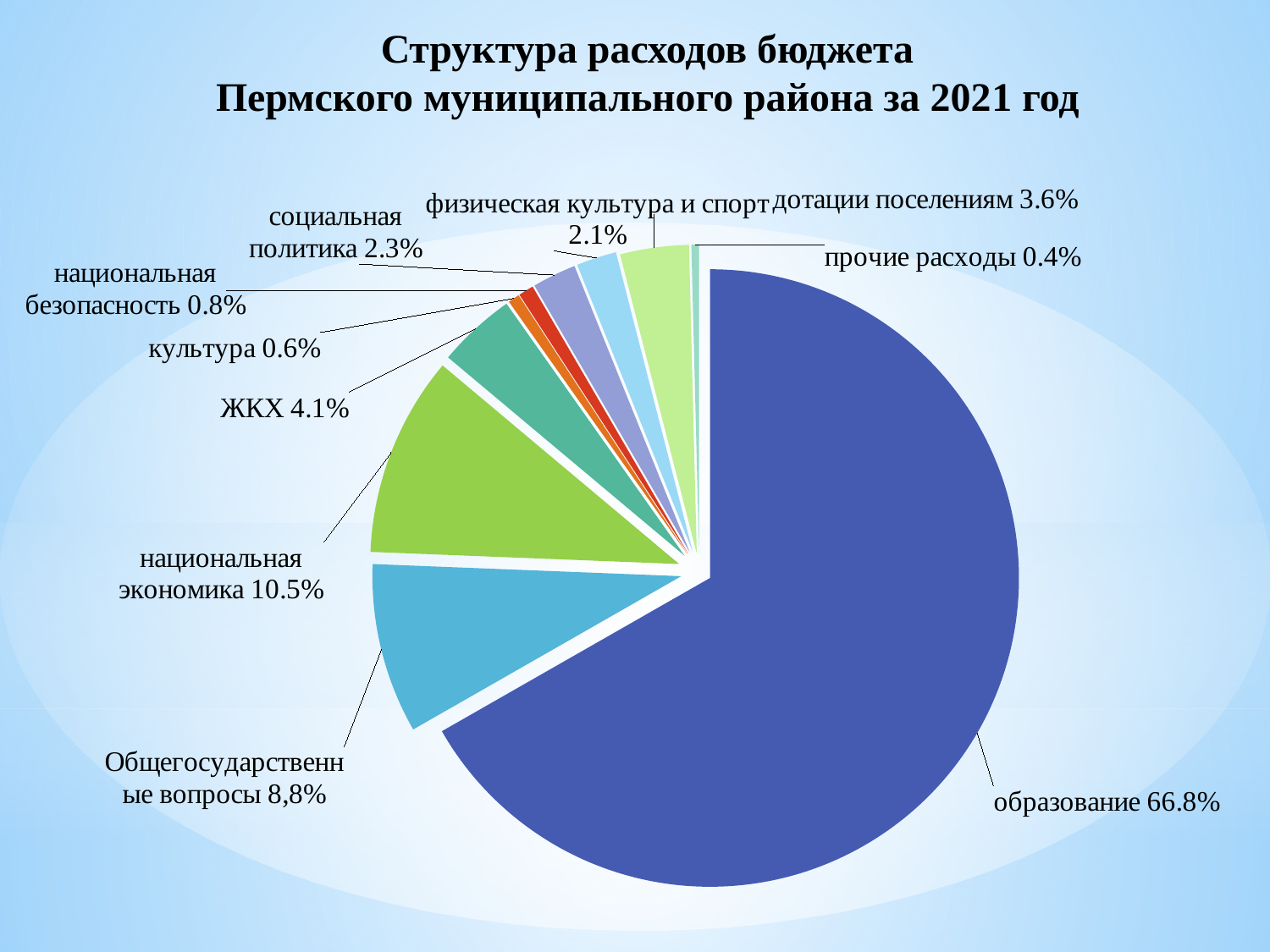
What share is shown for Общегосударственные вопросы? 8,8% What is the title of the chart? Структура расходов бюджета Пермского муниципального района за 2021 год How many slices does the pie chart have? 10 What share of budget expenditure goes to образование? 66.8% What is the difference between the share for национальная экономика and the share for ЖКХ? 6.4% What share is shown for дотации поселениям? 3.6% Which category has the largest share of the pie? образование What share of budget expenditure goes to национальная экономика? 10.5% What share is shown for ЖКХ? 4.1% Which is larger: the share for социальная политика or the share for физическая культура и спорт? социальная политика Which category has the smallest share of the pie? прочие расходы What kind of chart is shown on the slide? pie chart